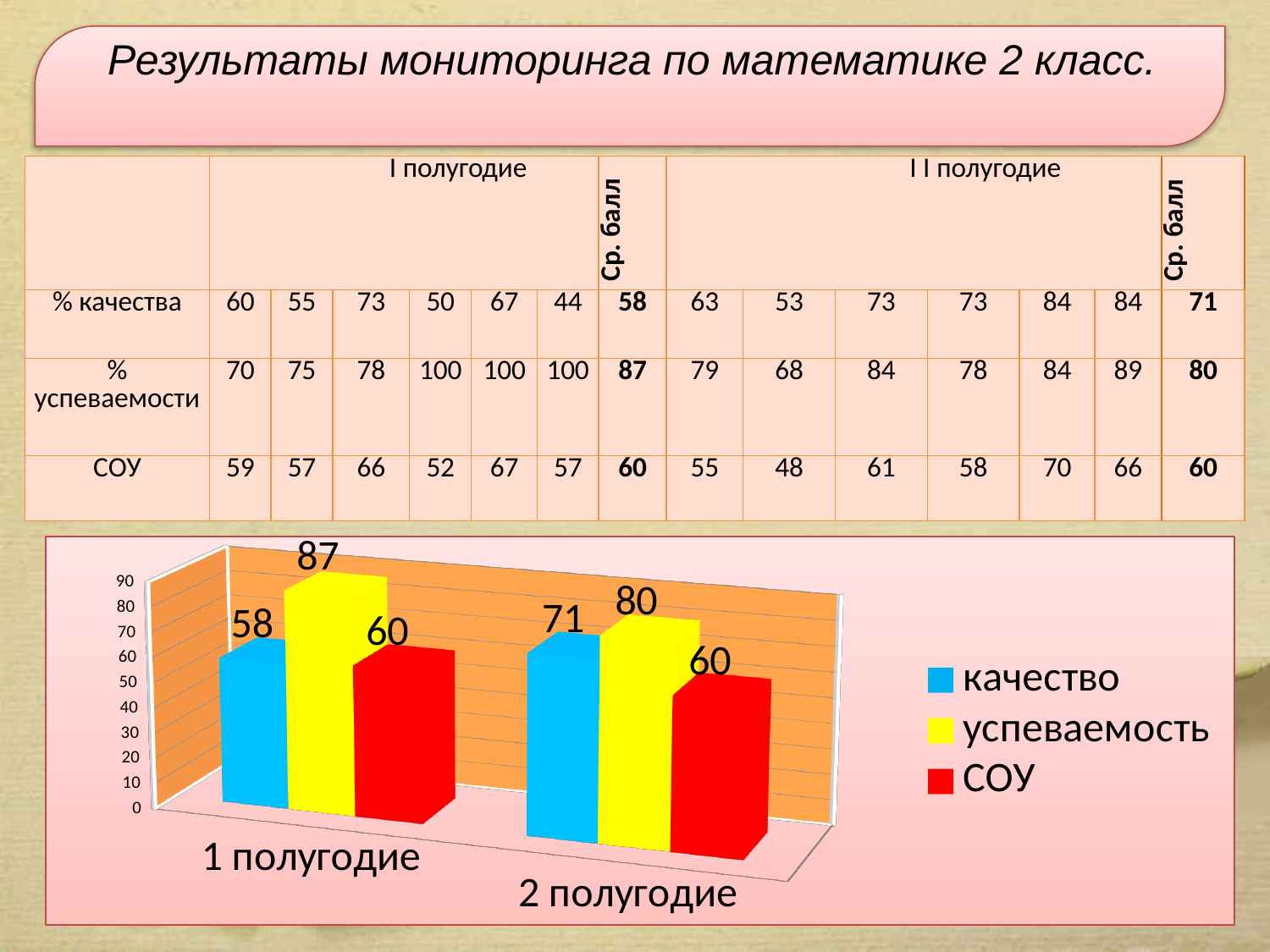
Which series has the lowest value for 2 полугодие? СОУ How many series does the chart legend list? 3 What kind of chart is shown on the slide? bar chart Which colour represents СОУ in the chart? red What is the value of успеваемость for 2 полугодие? 80 How many categories are shown on the x axis of the chart? 2 What is the value of качество for 2 полугодие? 71 Which series has the highest value for 1 полугодие? успеваемость What is the value of качество for 1 полугодие? 58 What is the value of СОУ for 1 полугодие? 60 What is the difference between успеваемость for 1 полугодие and 2 полугодие? 7 Which is larger: качество for 1 полугодие or качество for 2 полугодие? 2 полугодие